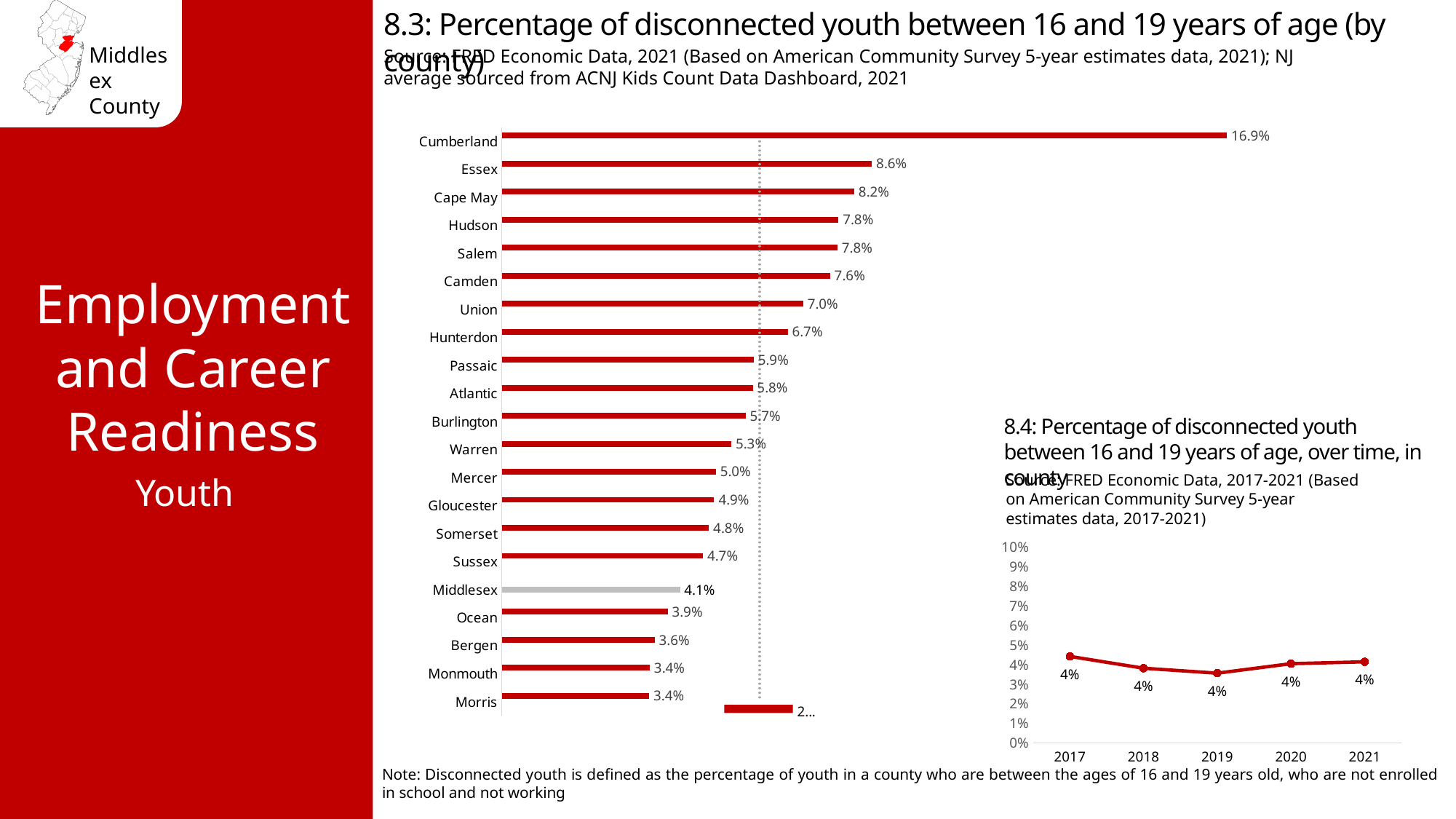
In chart 8.3, which has a higher value, Essex or Cape May? Essex What kind of chart is chart 8.3? Bar chart In chart 8.3, what is the difference between the values for Cumberland and Essex? 8.3% How many years are plotted in chart 8.4? 5 What kind of chart is chart 8.4? Line chart How many counties are shown in chart 8.3? 21 In chart 8.3, which county's bar is coloured grey instead of red? Middlesex In chart 8.3, what is the percentage of disconnected youth for Cumberland? 16.9% In chart 8.3, which has a higher value, Union or Ocean? Union In chart 8.3, what is the difference between the values for Essex and Middlesex? 4.5% In chart 8.3, which county has the highest percentage of disconnected youth? Cumberland In chart 8.3, what is the percentage of disconnected youth for Middlesex? 4.1%